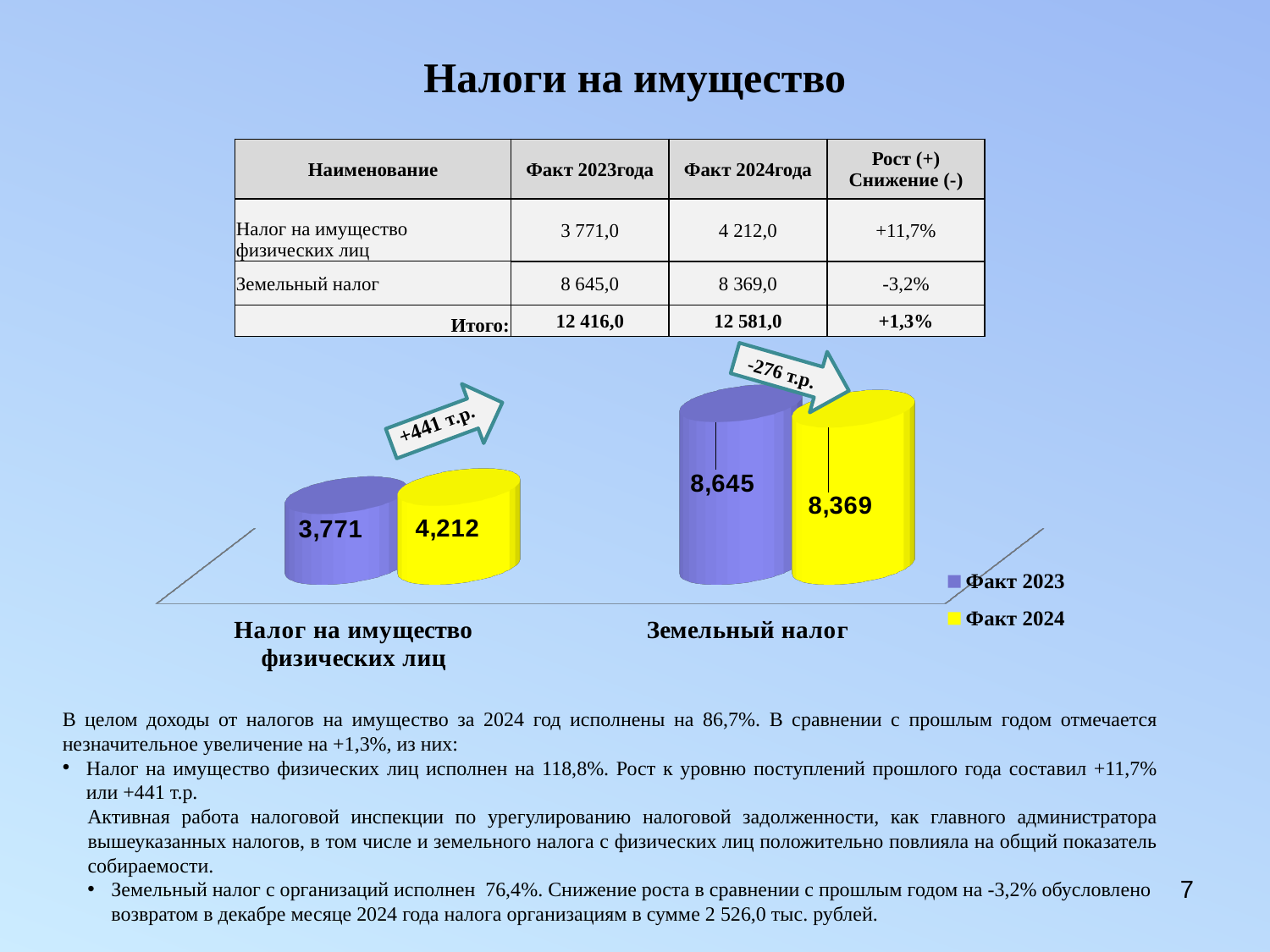
What is the value of Факт 2024 for Земельный налог in the chart? 8,369 What is the difference between the Факт 2023 and Факт 2024 values for Земельный налог? 276 How many categories are shown on the x axis of the chart? 2 How many series does the chart legend list? 2 What is the value of Факт 2024 for Налог на имущество физических лиц in the chart? 4,212 What is the difference between the Факт 2024 and Факт 2023 values for Налог на имущество физических лиц? 441 For Земельный налог, which is larger: Факт 2023 or Факт 2024? Факт 2023 Which category has the highest Факт 2024 value in the chart? Земельный налог What is the value of Факт 2023 for Налог на имущество физических лиц in the chart? 3,771 What type of chart is shown on the slide? Bar chart Which category has the lowest Факт 2023 value in the chart? Налог на имущество физических лиц What is the value of Факт 2023 for Земельный налог in the chart? 8,645